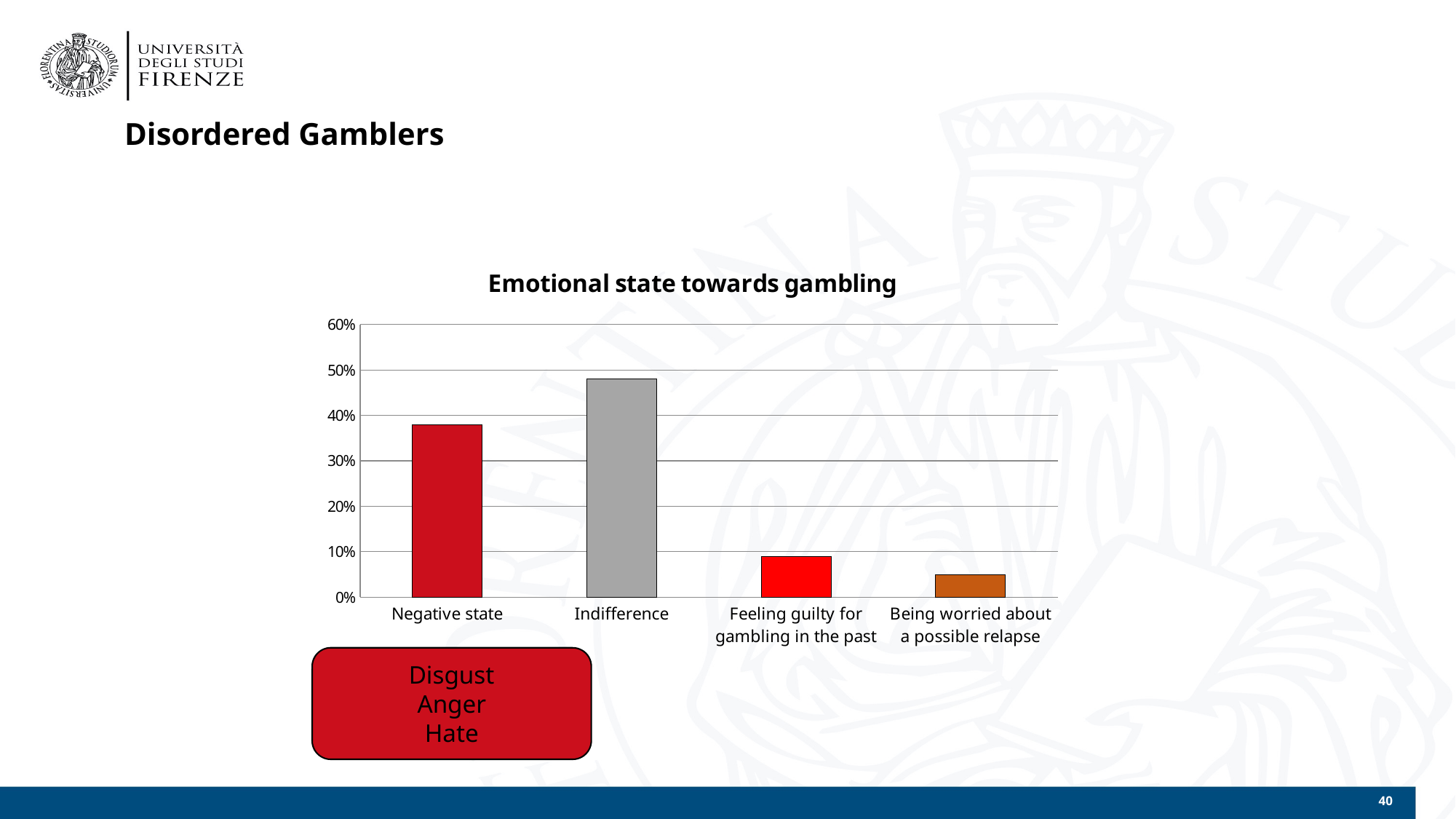
How many categories are shown on the x axis of the chart? 4 Which category has the highest value in the chart? Indifference Is the value for Negative state greater or less than 30%? greater Is the value for Feeling guilty for gambling in the past greater or less than 20%? less Which category has the lowest value in the chart? Being worried about a possible relapse What is the title of the chart? Emotional state towards gambling What three words are listed in the red box below the Negative state bar? Disgust, Anger, Hate Which is larger, the value for Negative state or the value for Indifference? Indifference Which is larger, the value for Feeling guilty for gambling in the past or the value for Being worried about a possible relapse? Feeling guilty for gambling in the past What kind of chart is shown on the slide? bar chart Is the value for Being worried about a possible relapse greater or less than 10%? less